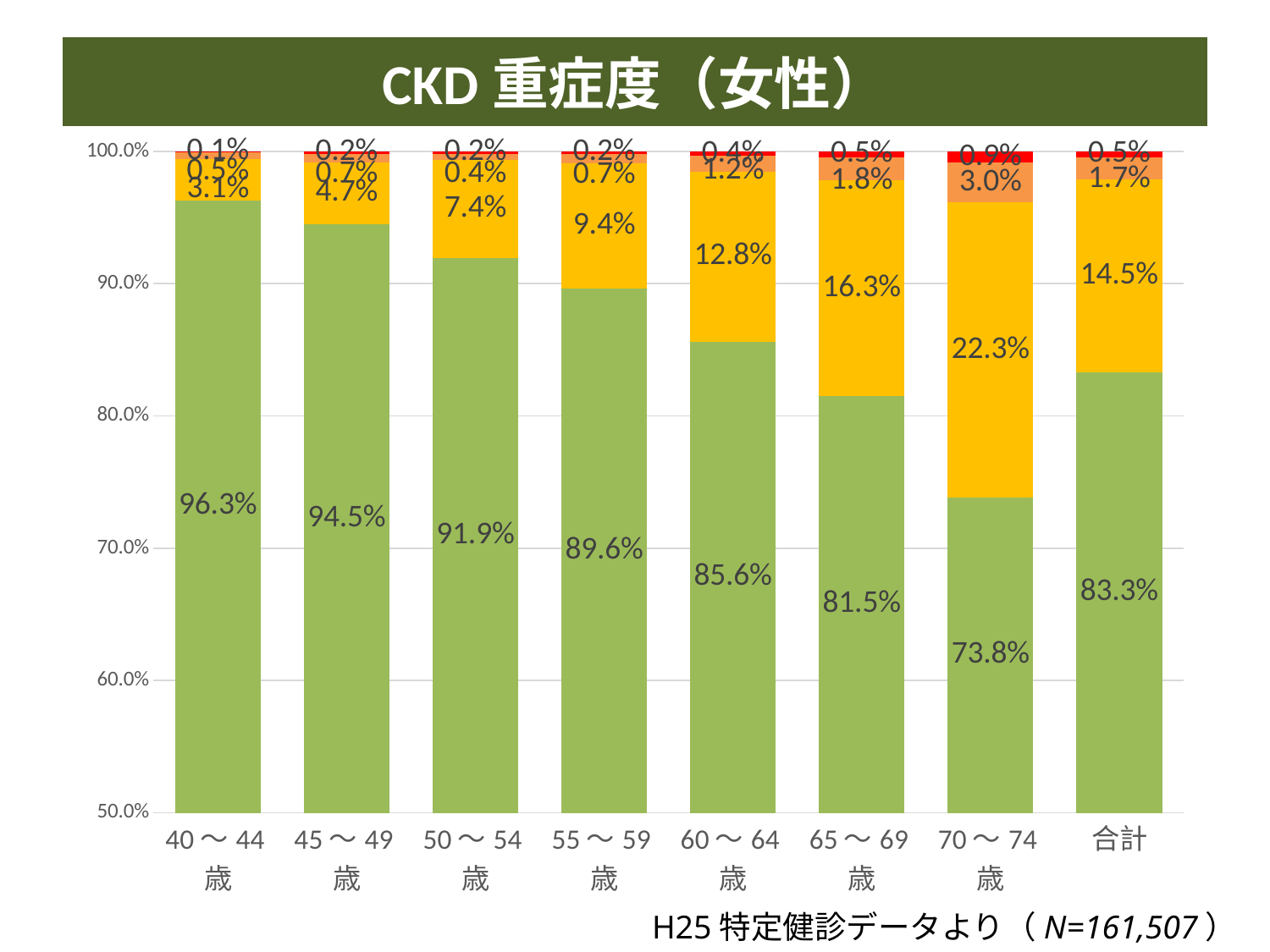
What is the value of the yellow segment for the 65〜69歳 group? 16.3% Which age group has the lowest green segment value? 70〜74歳 Does the green segment value rise or fall as the age groups increase from 40〜44歳 to 70〜74歳? Fall Which is larger, the yellow segment for 60〜64歳 or for 55〜59歳? 60〜64歳 What kind of chart is shown on the slide? Stacked bar chart What is the value of the green segment for the 70〜74歳 group? 73.8% What is the value of the orange segment for the 70〜74歳 group? 3.0% What is the title of the chart? CKD 重症度（女性） What is the difference between the green segment values for 40〜44歳 and 70〜74歳? 22.5 percentage points Which age group has the highest green segment value? 40〜44歳 How many bars are shown on the chart? 8 What is the value of the green segment for the 合計 bar? 83.3%